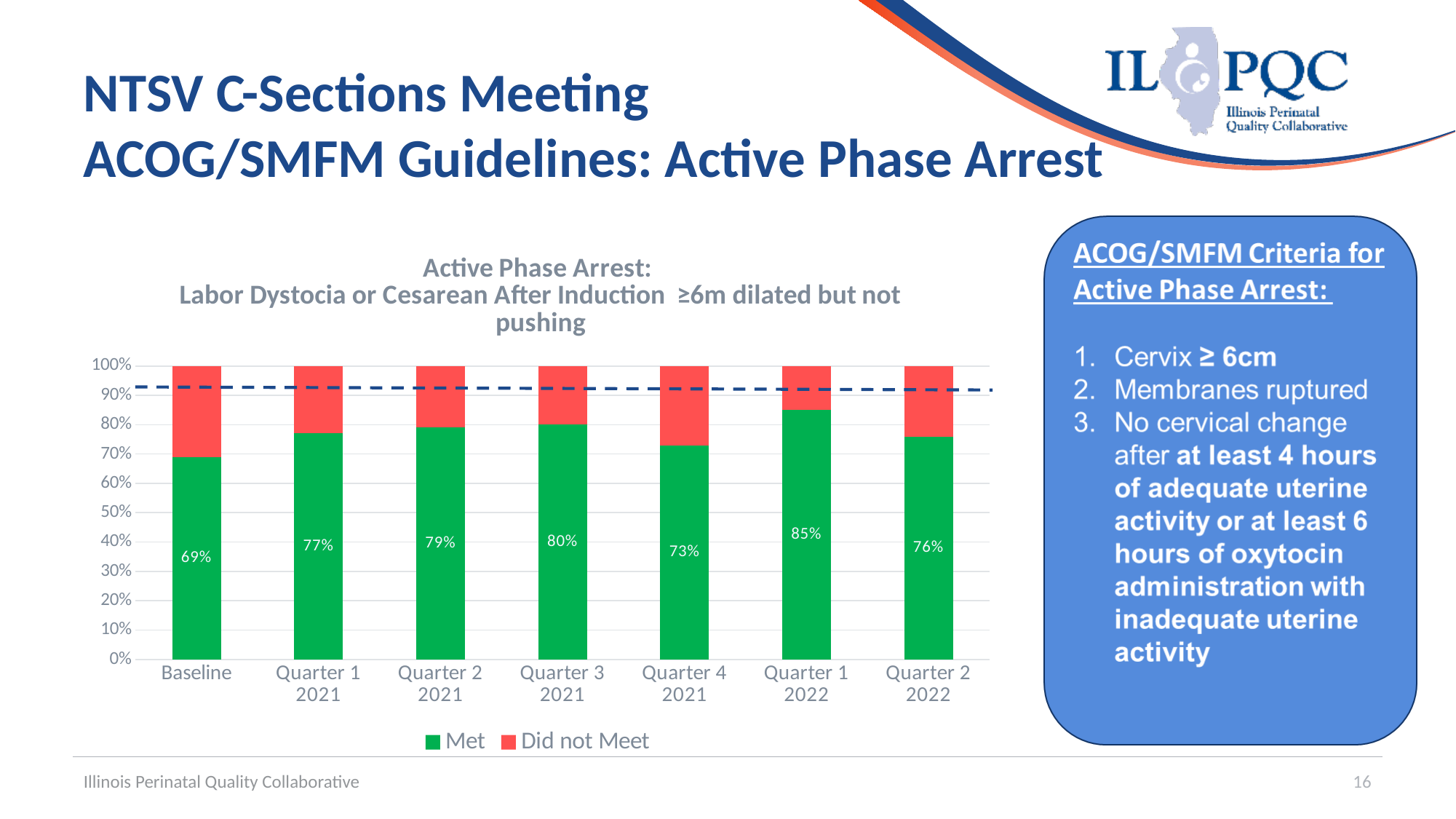
Which period has the highest Met value? Quarter 1 2022 What kind of chart is shown on the slide? Stacked bar chart What is the Met value for Quarter 1 2022? 85% What is the difference between the Met value for Quarter 1 2022 and the Met value for Baseline? 16% What is the Met value for Baseline? 69% Which period has the lowest Met value? Baseline How many series does the legend list? 2 How many periods are shown on the x axis? 7 What is the Met value for Quarter 4 2021? 73% What is the Met value for Quarter 2 2022? 76% Which colour represents the Met series? Green Which is larger, the Met value for Quarter 3 2021 or the Met value for Quarter 4 2021? Quarter 3 2021